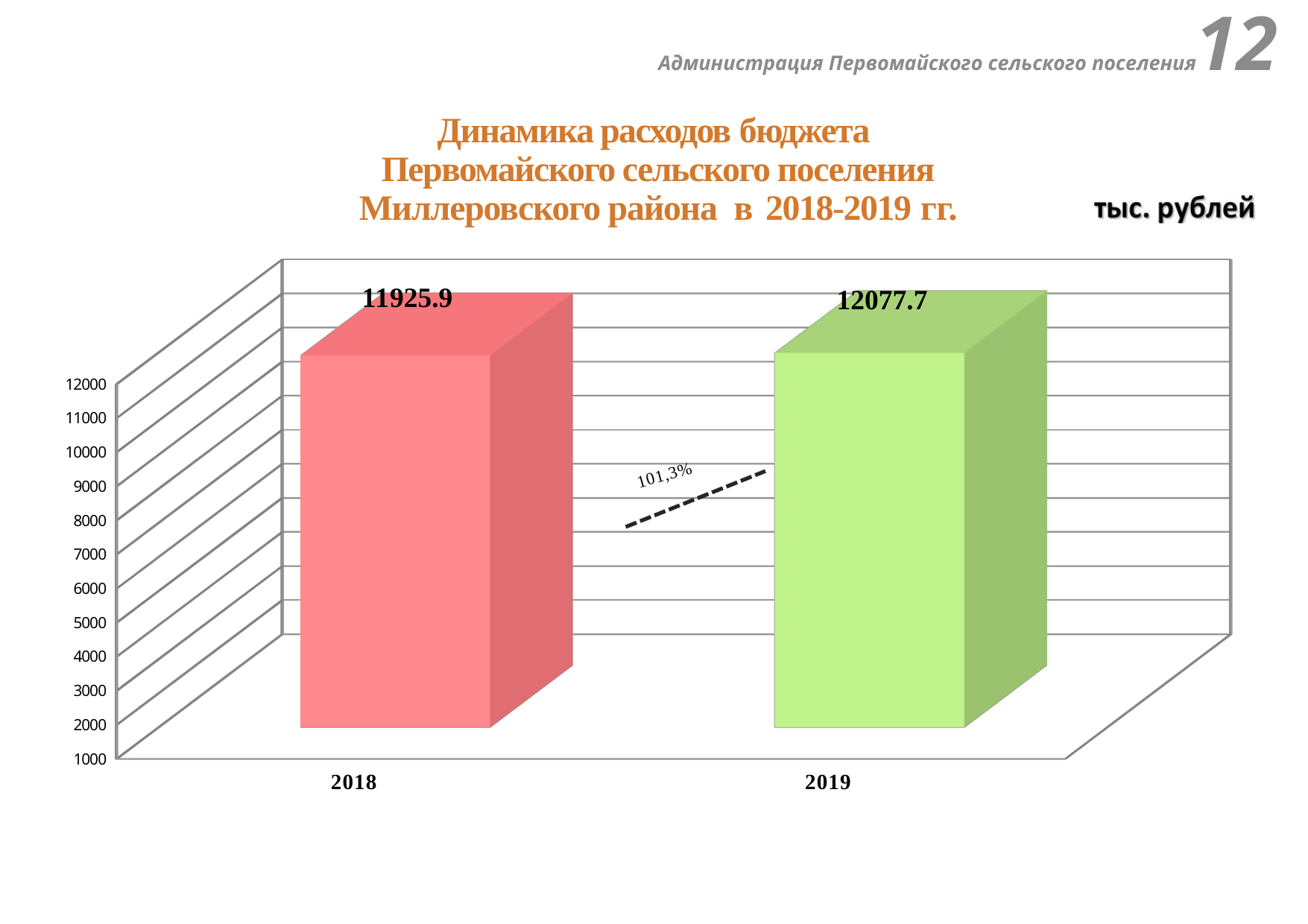
Which year has the lower value? 2018 Do the values rise or fall from 2018 to 2019? Rise What is the value for 2019? 12077.7 How many years are shown on the chart? 2 What is the difference between the 2019 and 2018 values? 151.8 What percentage is written on the dashed line between the bars? 101,3% Is the value for 2019 larger than the value for 2018? Yes Which year has the higher value? 2019 What kind of chart is shown on the slide? Bar chart What unit of measurement is indicated on the slide? тыс. рублей What is the value for 2018? 11925.9